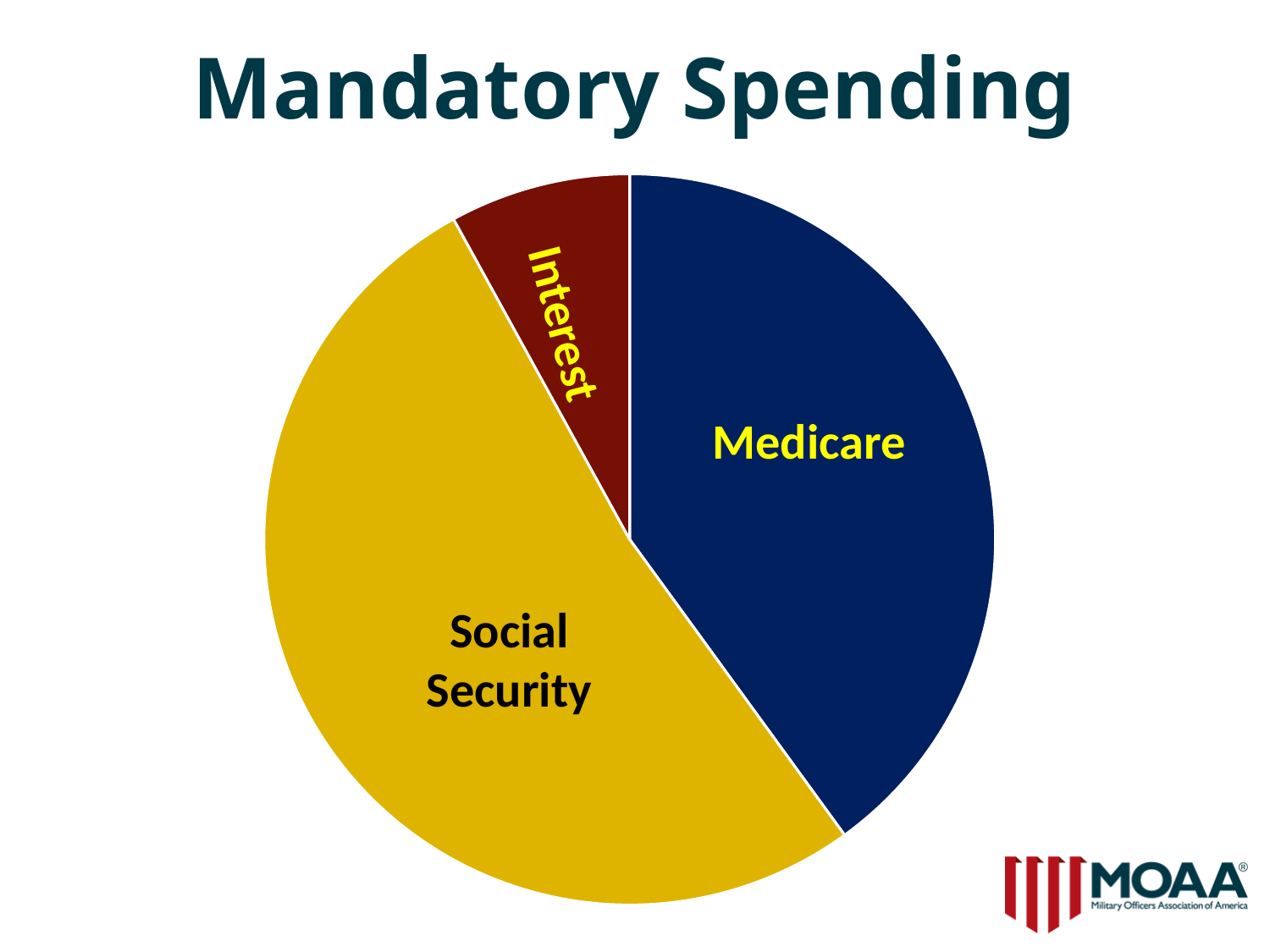
Which category has the largest slice of the pie chart? Social Security Which slice is larger, Social Security or Medicare? Social Security What colour is the Medicare slice? Dark blue What kind of chart is shown on the slide? Pie chart What is the title of the chart? Mandatory Spending Which slice is larger, Medicare or Interest? Medicare Which slice is smaller, Social Security or Interest? Interest How many slices does the pie chart have? 3 Which category has the smallest slice of the pie chart? Interest